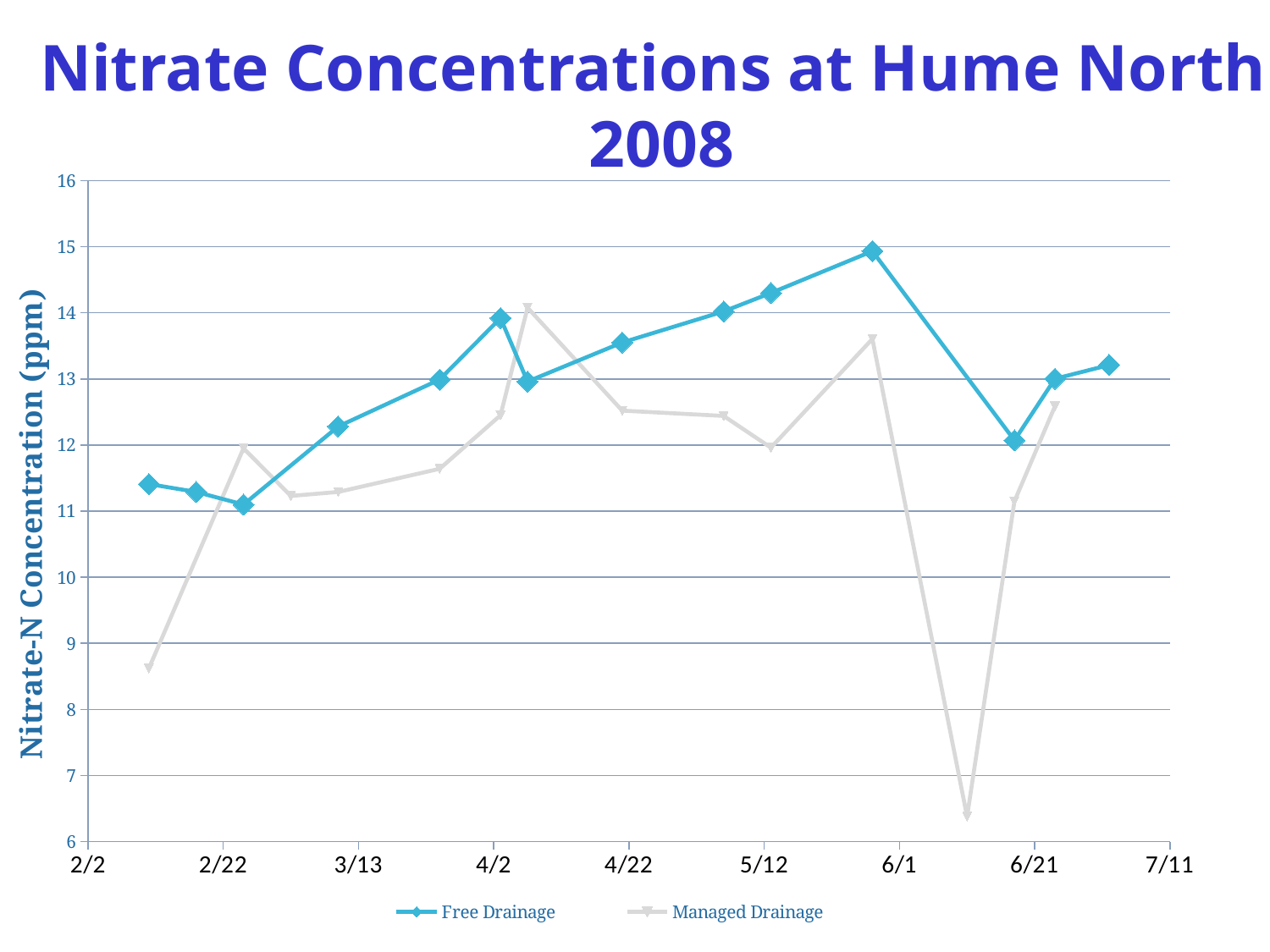
Is the lowest value of the Managed Drainage series (between 6/1 and 6/21) greater or less than 7? less Is the first Free Drainage value (shortly after 2/2) greater or less than 11? greater What are the two series named in the legend? Free Drainage and Managed Drainage What is the label on the vertical axis? Nitrate-N Concentration (ppm) How many series does the legend list? 2 Just before 6/1, which series has the higher value, Free Drainage or Managed Drainage? Free Drainage Is the peak value of the Free Drainage series (just before 6/1) greater or less than 14? greater Which series reaches the highest value on the chart? Free Drainage What kind of chart is shown on the slide? line chart Does the Free Drainage series generally rise or fall between 2/22 and 6/1? rise Which series reaches the lowest value on the chart? Managed Drainage